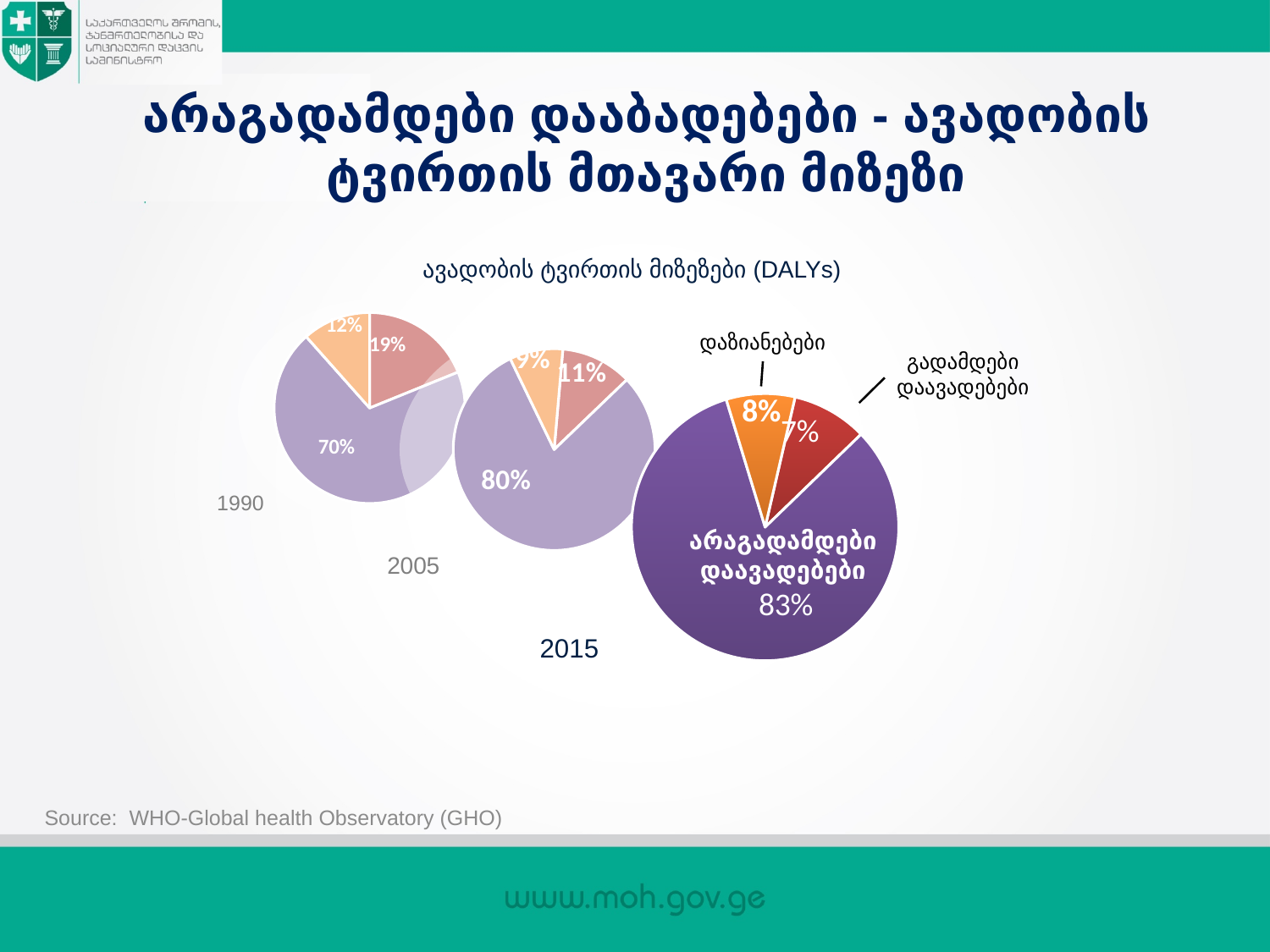
In the 1990 pie chart, what is the largest slice's share? 70% In the 2015 pie chart, what share is labelled for გადამდები დაავადებები (communicable diseases)? 7% In the 1990 pie chart, what is the smallest slice's share? 12% What kind of charts are shown on the slide? Pie charts In the 2005 pie chart, what is the largest slice's share? 80% What is the title shown above the pie charts? ავადობის ტვირთის მიზეზები (DALYs) Does the share of the largest slice rise or fall across the 1990, 2005 and 2015 pie charts? Rise In the 2005 pie chart, what is the smallest slice's share? 9% In the 2015 pie chart, what share is labelled for დაზიანებები (injuries)? 8% In the 2015 pie chart, what share is labelled for არაგადამდები დაავადებები (noncommunicable diseases)? 83% By how many percentage points did the largest slice grow from the 1990 pie chart (70%) to the 2015 pie chart (83%)? 13 percentage points How many pie charts are shown on the slide? 3